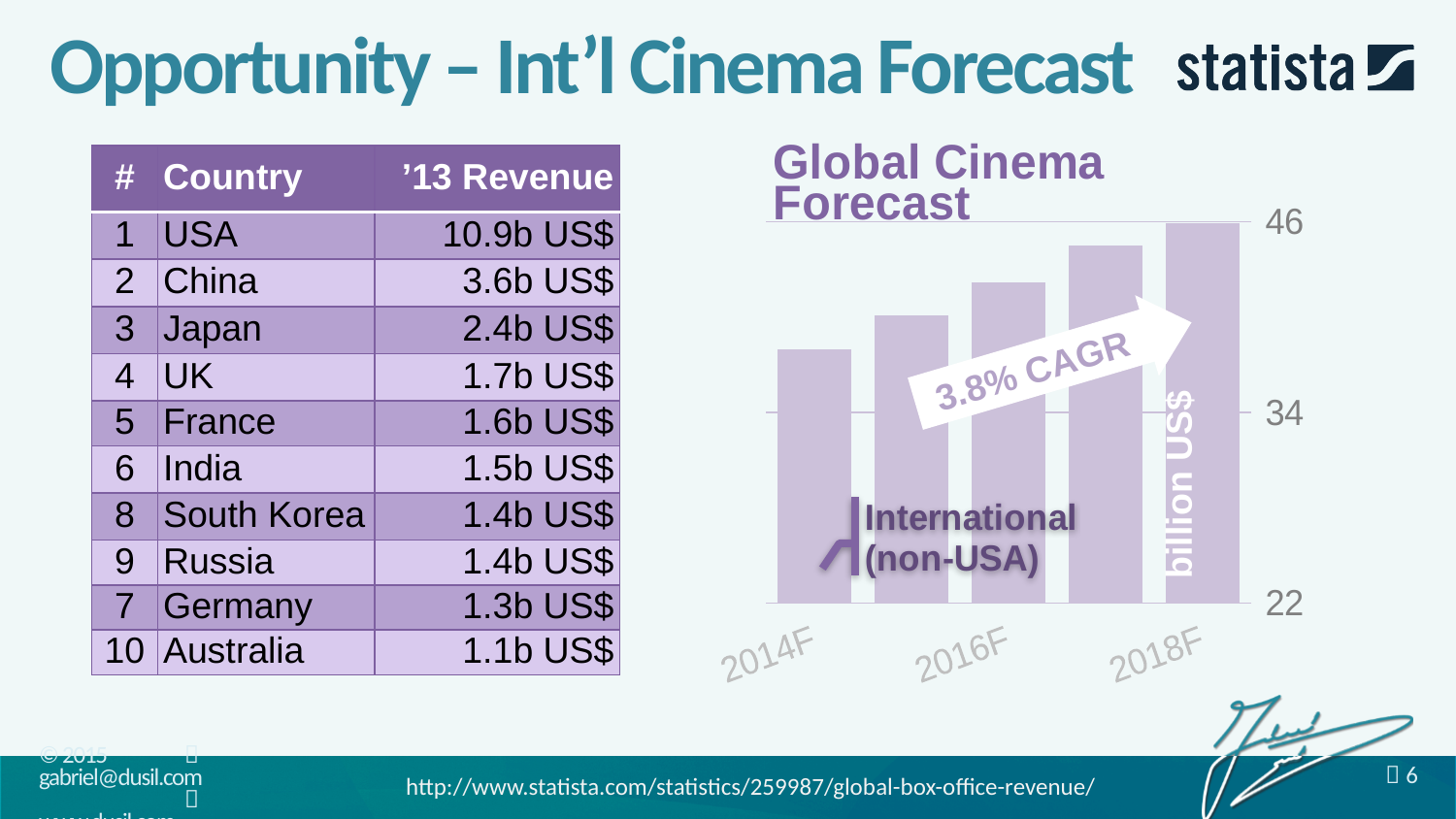
Do the values in the Global Cinema Forecast chart rise or fall from 2014F to 2018F? rise How many series does the legend of the Global Cinema Forecast chart list? 1 How many bars are plotted in the Global Cinema Forecast chart? 5 In the Global Cinema Forecast chart, is the value for 2014F greater or less than 34? greater In the Global Cinema Forecast chart, which is larger, the value for 2018F or the value for 2014F? 2018F Which year has the highest bar in the Global Cinema Forecast chart? 2018F In the Global Cinema Forecast chart, is the value for 2016F greater or less than 34? greater What series name is shown in the legend of the Global Cinema Forecast chart? International (non-USA) What is the title of the chart on the slide? Global Cinema Forecast In the Global Cinema Forecast chart, is the value for 2014F greater or less than 46? less What kind of chart is shown on the slide? bar chart Which year has the lowest bar in the Global Cinema Forecast chart? 2014F